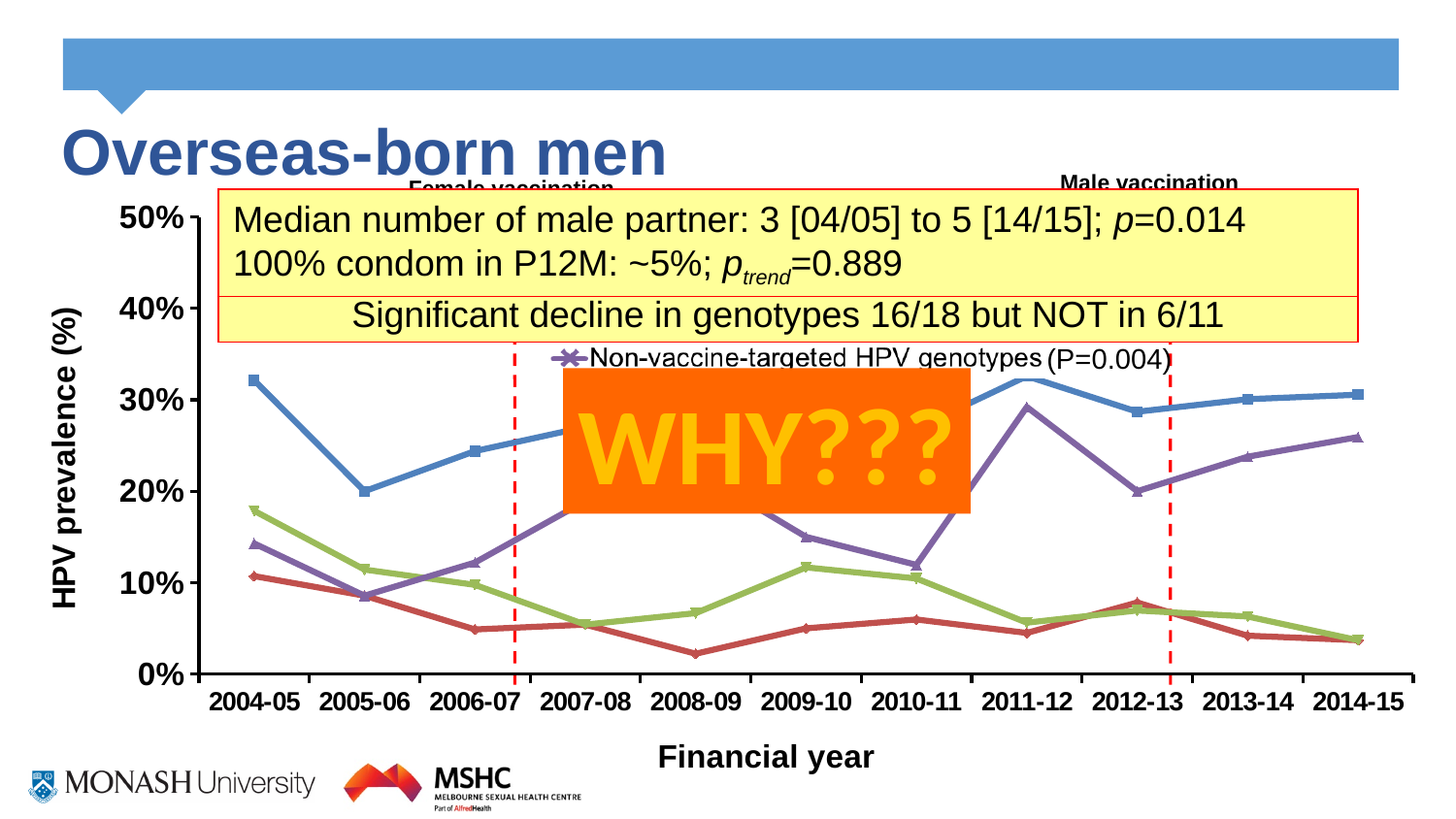
Is the value for Non-vaccine-targeted HPV genotypes in 2014-15 greater or less than 20%? greater In which financial year is the Non-vaccine-targeted HPV genotypes series at its highest? 2011-12 What is the title of the slide containing the chart? Overseas-born men Is the value for Non-vaccine-targeted HPV genotypes in 2005-06 greater or less than 10%? less Is the value for Non-vaccine-targeted HPV genotypes in 2004-05 greater or less than 10%? greater What is the label of the y axis of the chart? HPV prevalence (%) In which financial year is the Non-vaccine-targeted HPV genotypes series at its lowest? 2005-06 What kind of chart is shown on the slide? line chart For Non-vaccine-targeted HPV genotypes, which is larger: the value in 2011-12 or the value in 2012-13? 2011-12 How many financial years are shown on the x axis of the chart? 11